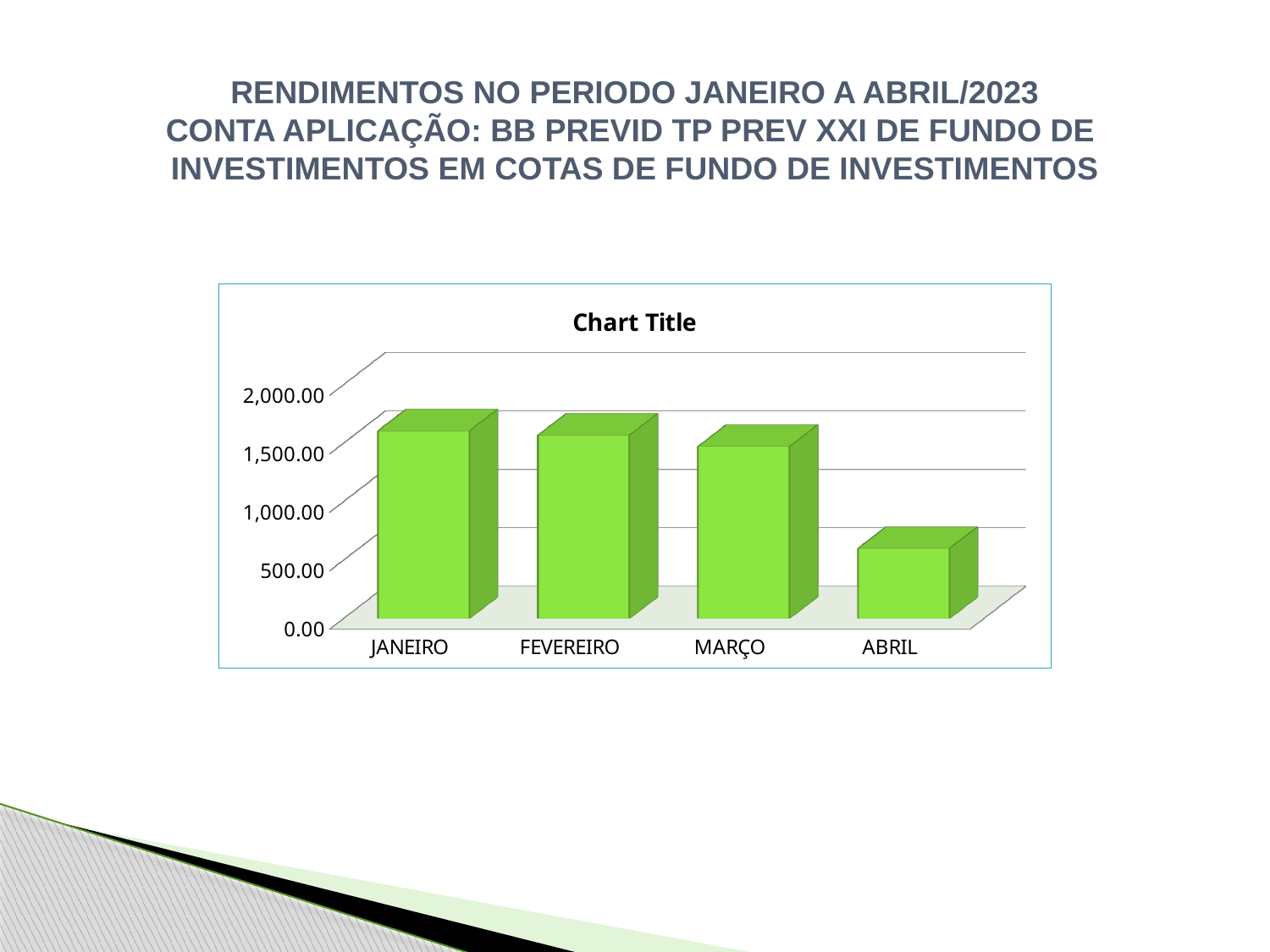
Is the value for FEVEREIRO greater or less than 1,000.00? greater Is the value for ABRIL greater or less than 500.00? greater Do the values rise or fall from JANEIRO to ABRIL along the x axis? fall Is the value for JANEIRO greater or less than 1,500.00? greater What title is printed above the chart's plot area? Chart Title Which is larger, the value for MARÇO or the value for ABRIL? MARÇO How many categories are plotted on the x axis of the chart? 4 Which is larger, the value for JANEIRO or the value for ABRIL? JANEIRO What kind of chart is shown on the slide? bar chart Which month has the lowest value in the chart? ABRIL